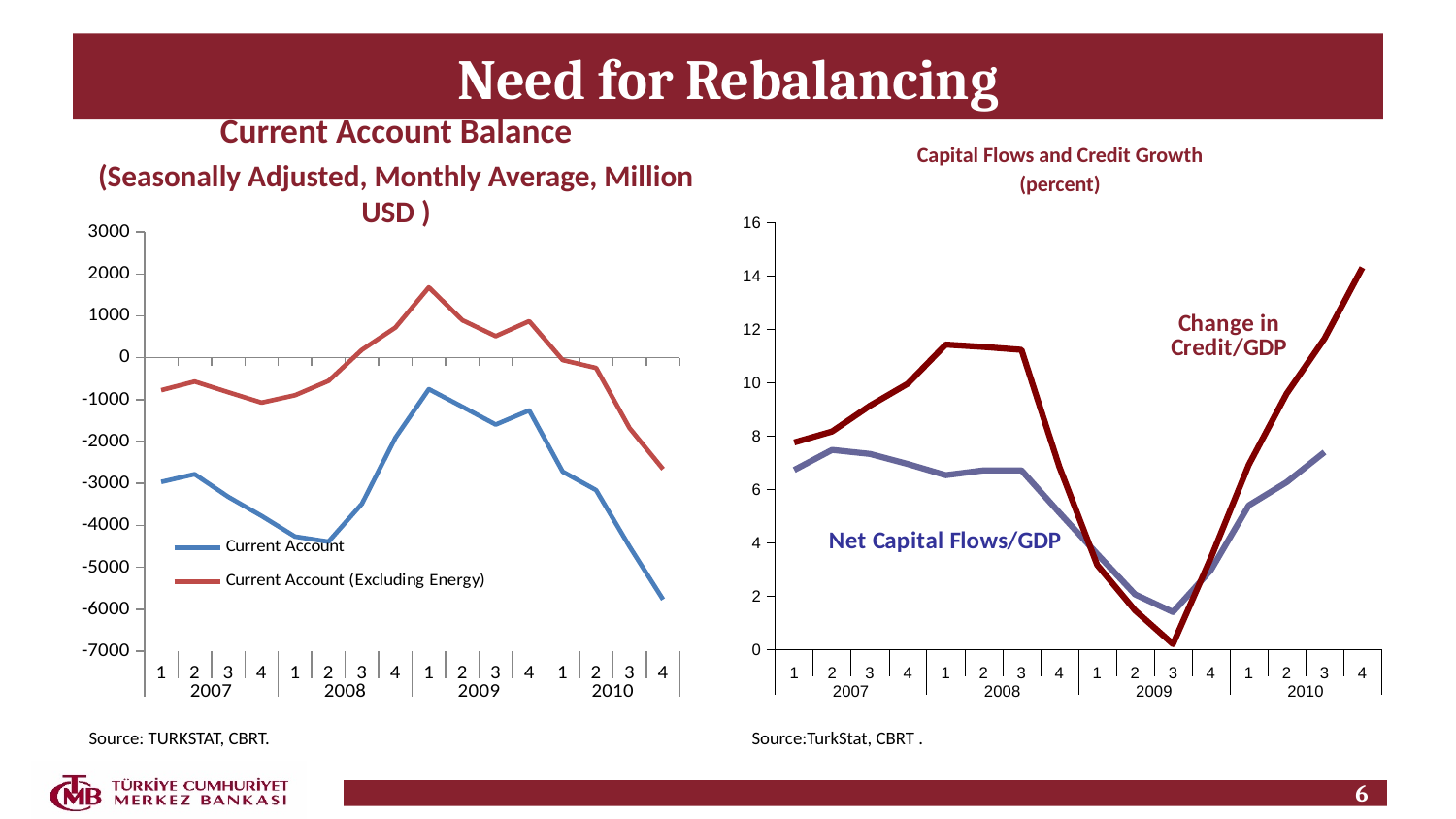
How many quarterly data points are plotted for each series in the Current Account Balance chart? 16 In the Current Account Balance chart, in which quarter does the Current Account series reach its lowest value? Quarter 4 of 2010 In the Capital Flows and Credit Growth chart, does the Change in Credit/GDP series rise or fall from quarter 3 of 2009 to quarter 4 of 2010? Rise In the Current Account Balance chart, which series is higher in quarter 1 of 2009: Current Account or Current Account (Excluding Energy)? Current Account (Excluding Energy) What kind of chart is the Capital Flows and Credit Growth chart on the right? Line chart How many series does the legend of the Current Account Balance chart list? 2 In the Capital Flows and Credit Growth chart, in which quarter does the Change in Credit/GDP series reach its lowest value? Quarter 3 of 2009 In the Capital Flows and Credit Growth chart, which series is higher in quarter 1 of 2008: Change in Credit/GDP or Net Capital Flows/GDP? Change in Credit/GDP What kind of chart is the Current Account Balance chart on the left? Line chart In the Capital Flows and Credit Growth chart, is the Change in Credit/GDP value for quarter 4 of 2010 greater or less than 12? greater In the Current Account Balance chart, is the Current Account value for quarter 4 of 2010 greater or less than -5000? less In the Current Account Balance chart, in which quarter does the Current Account (Excluding Energy) series reach its highest value? Quarter 1 of 2009